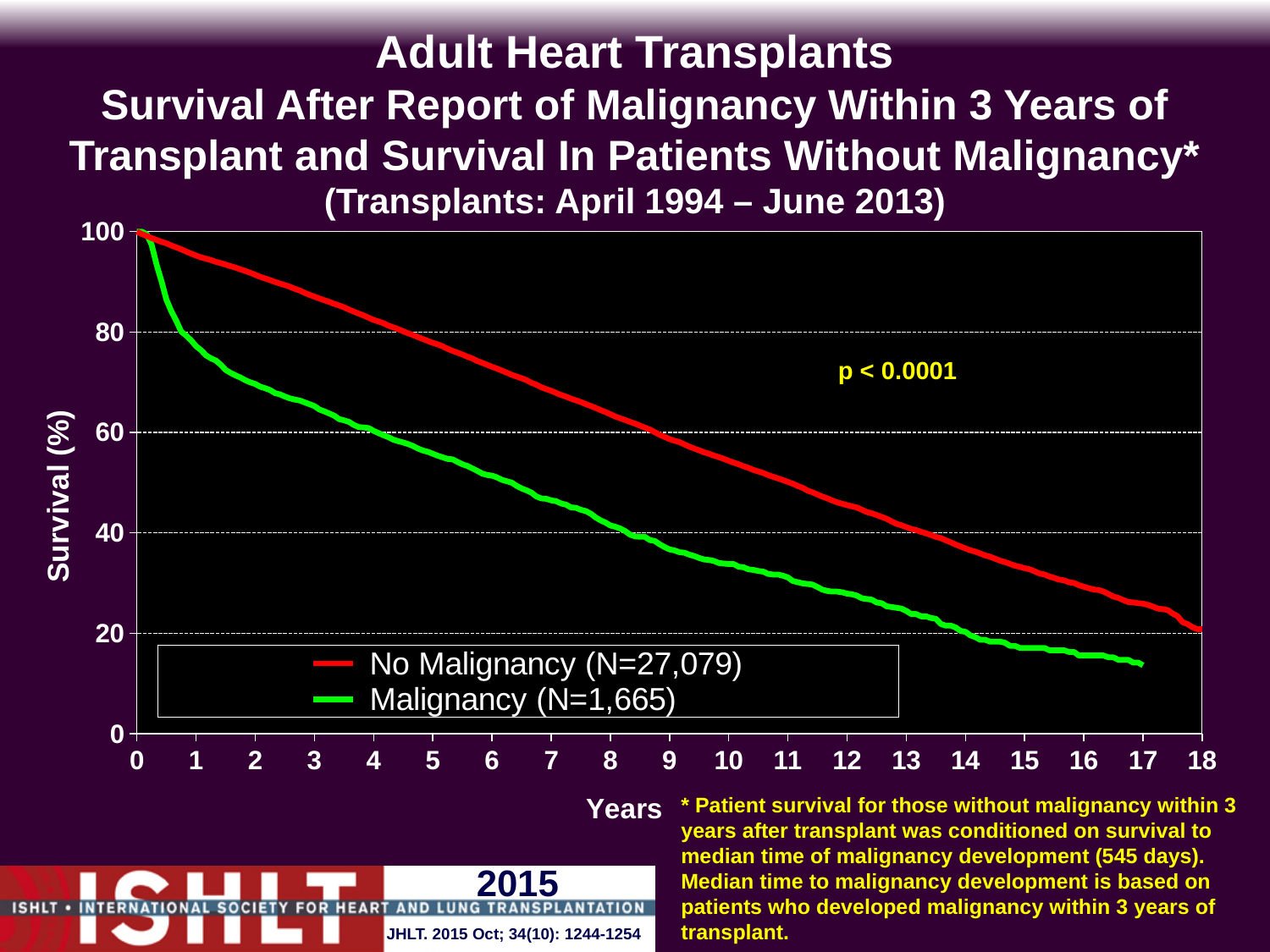
Do the survival curves rise or fall as years since transplant increase? fall How many series does the legend list? 2 At 10 years, which series has the higher survival, No Malignancy or Malignancy? No Malignancy Is the survival for the No Malignancy series at 10 years greater or less than 60? less What p-value is printed on the chart? p < 0.0001 What is the survival value for both series at year 0? 100 Is the survival for the Malignancy series at 2 years greater or less than 80? less Is the survival for the Malignancy series at 17 years greater or less than 20? less What kind of chart is shown on the slide? line chart What is the N for the No Malignancy series shown in the legend? 27,079